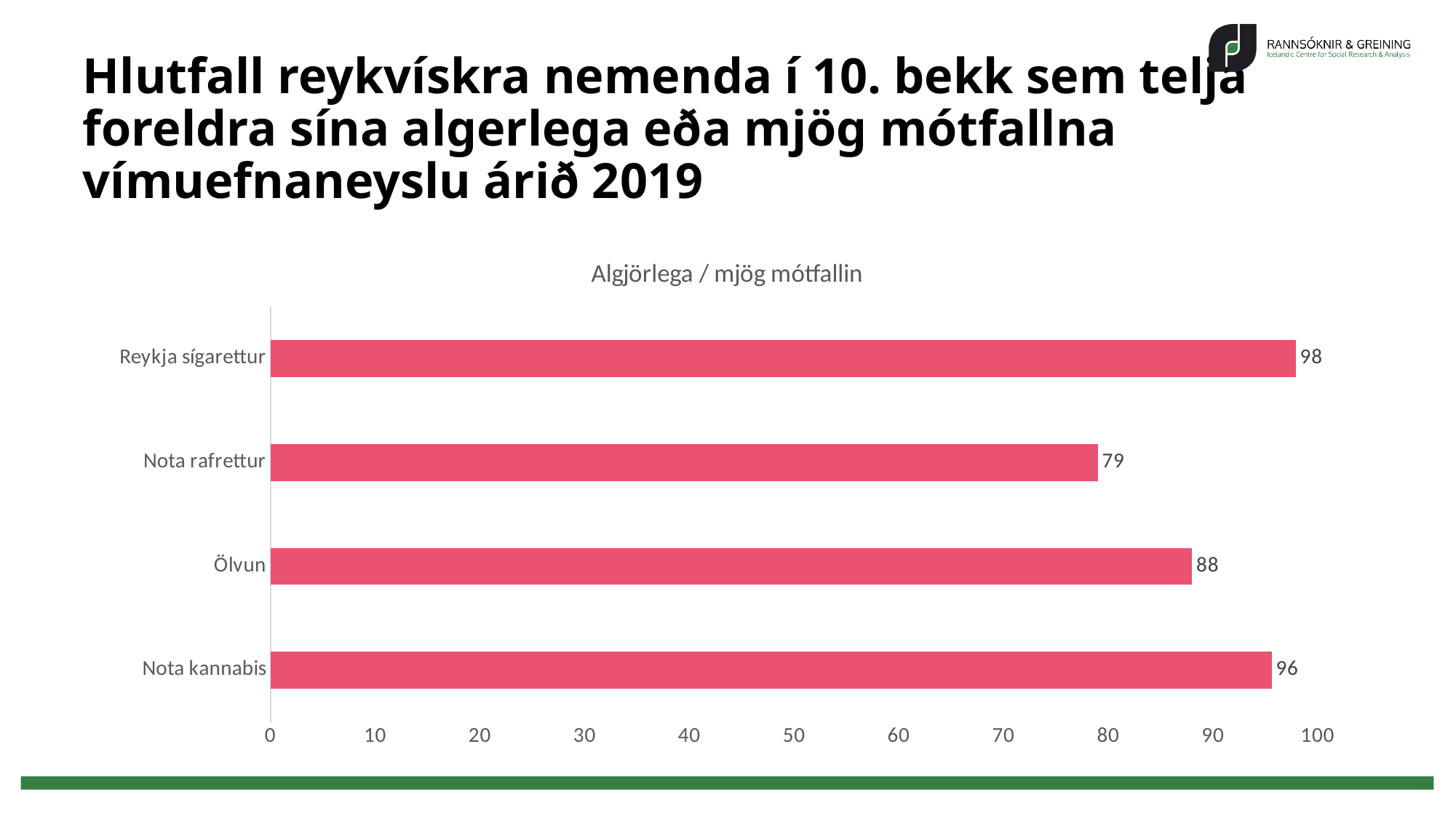
What is the value for Ölvun? 88 How many categories are shown in the chart? 4 What is the value for Nota rafrettur? 79 Which is larger, the value for Ölvun or the value for Nota rafrettur? Ölvun What is the value for Nota kannabis? 96 Which category has the lowest value? Nota rafrettur What is the title shown above the chart? Algjörlega / mjög mótfallin Which category has the highest value? Reykja sígarettur What is the difference between the values for Reykja sígarettur and Nota rafrettur? 19 What kind of chart is shown on the slide? Bar chart What is the value for Reykja sígarettur? 98 What is the difference between the values for Nota kannabis and Ölvun? 8